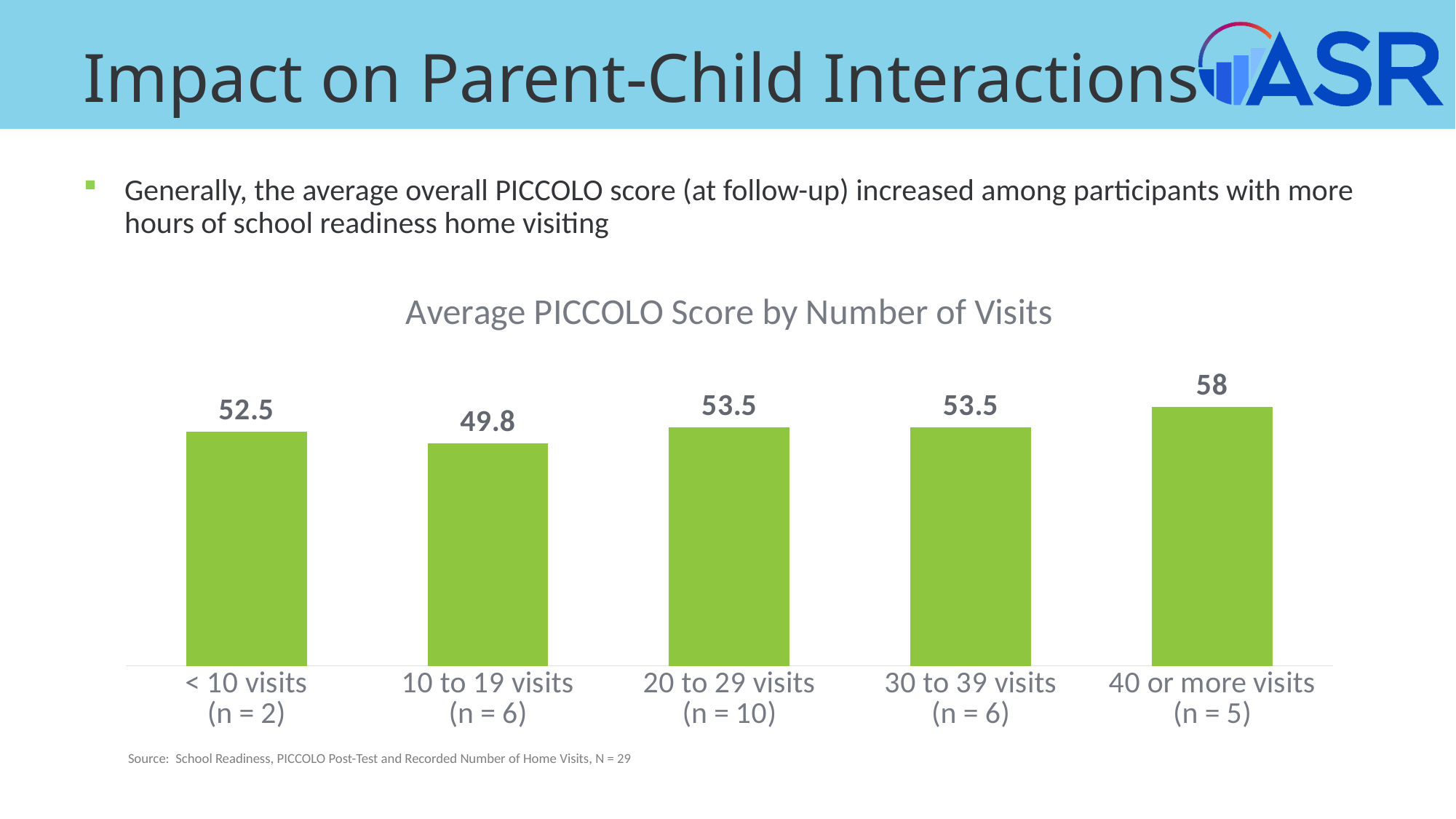
What kind of chart is shown on the slide? Bar chart Which visit category has the lowest average PICCOLO score? 10 to 19 visits Which visit category has the highest average PICCOLO score? 40 or more visits Which is larger, the average PICCOLO score for < 10 visits or for 10 to 19 visits? < 10 visits What is the average PICCOLO score for participants with 40 or more visits? 58 What is the difference between the average PICCOLO score for 20 to 29 visits and for < 10 visits? 1 What is the average PICCOLO score for participants with < 10 visits? 52.5 What is the difference between the average PICCOLO score for 40 or more visits and for 10 to 19 visits? 8.2 What is the title of the chart? Average PICCOLO Score by Number of Visits What is the average PICCOLO score for participants with 10 to 19 visits? 49.8 How many visit categories are shown in the chart? 5 How many participants (n) are in the 20 to 29 visits category? 10